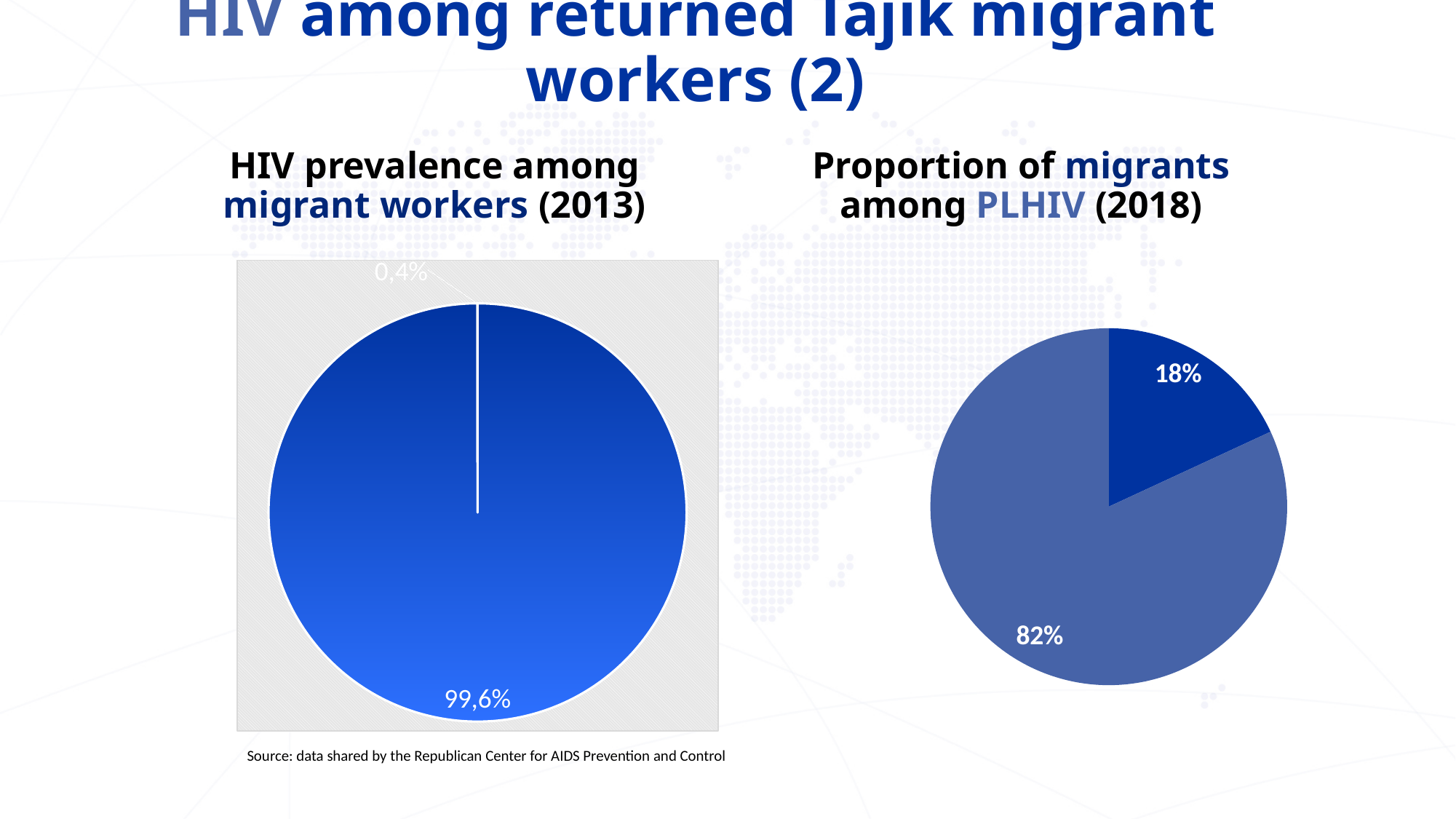
In the 'HIV prevalence among migrant workers (2013)' chart, what is the difference between the two slice values? 99,2% What kind of chart is the 'Proportion of migrants among PLHIV (2018)' chart? pie chart In the 'Proportion of migrants among PLHIV (2018)' chart, what value is shown for the dark blue slice? 18% In the 'HIV prevalence among migrant workers (2013)' chart, what value is shown for the large slice? 99,6% What kind of chart is the 'HIV prevalence among migrant workers (2013)' chart? pie chart In the 'Proportion of migrants among PLHIV (2018)' chart, what value is shown for the larger slice? 82% In the 'HIV prevalence among migrant workers (2013)' chart, what value is shown for the small slice at the top? 0,4% In the 'Proportion of migrants among PLHIV (2018)' chart, what is the difference between the two slice values? 64% In the 'Proportion of migrants among PLHIV (2018)' chart, is the dark blue slice larger or smaller than the lighter blue slice? smaller How many slices does the 'Proportion of migrants among PLHIV (2018)' pie chart have? 2 Which year is shown in the title of the chart on the right? 2018 How many slices does the 'HIV prevalence among migrant workers (2013)' pie chart have? 2